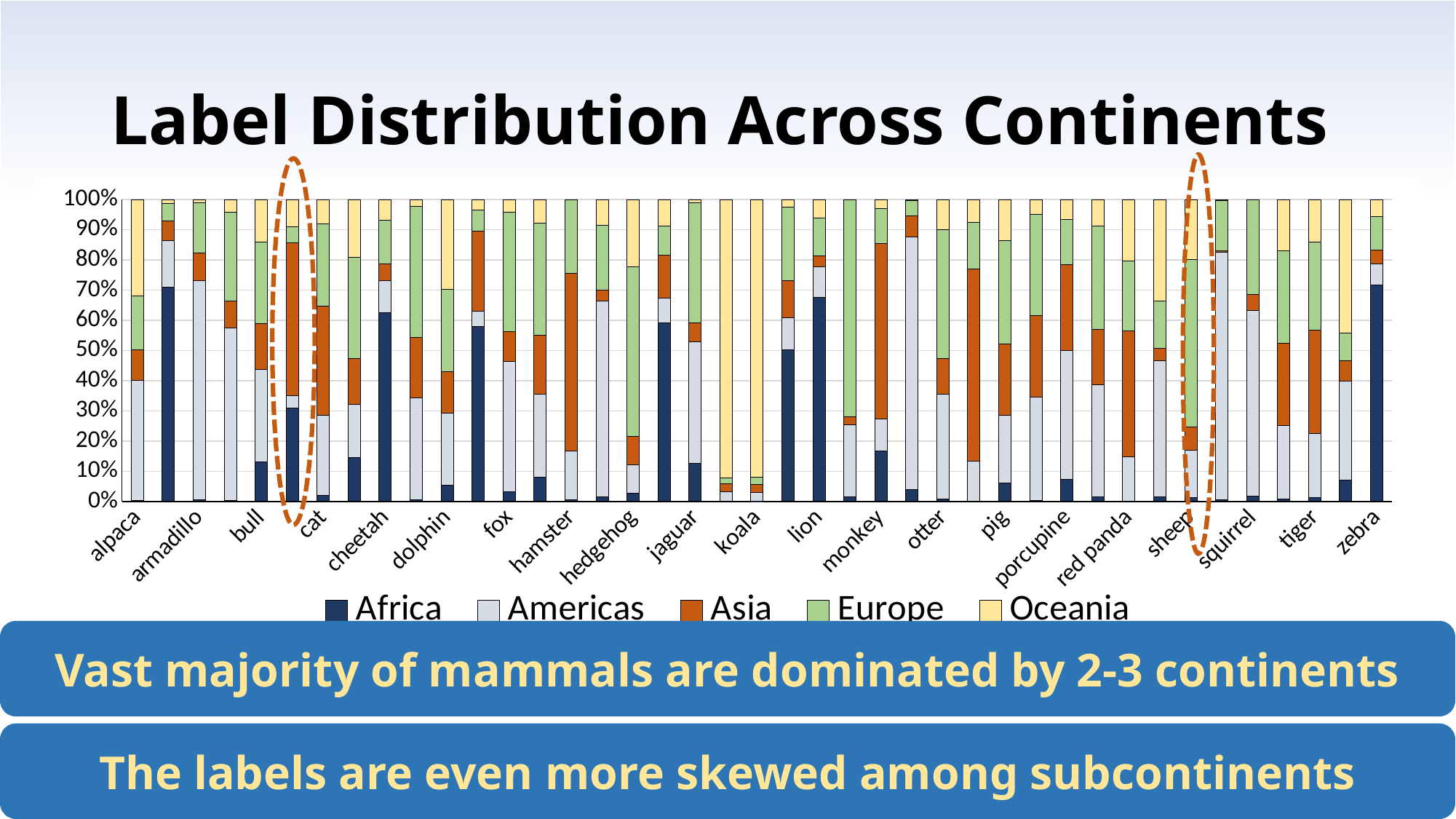
What type of chart is shown on the slide? Stacked bar chart Is the Oceania share for koala greater or less than 80%? greater Is the Africa share for zebra greater or less than 60%? greater How many series does the legend list? 5 Which is larger for koala, the Oceania share or the Africa share? Oceania Is the Africa share for koala greater or less than 10%? less What is the title of the chart? Label Distribution Across Continents Which series are listed in the legend? Africa, Americas, Asia, Europe, Oceania